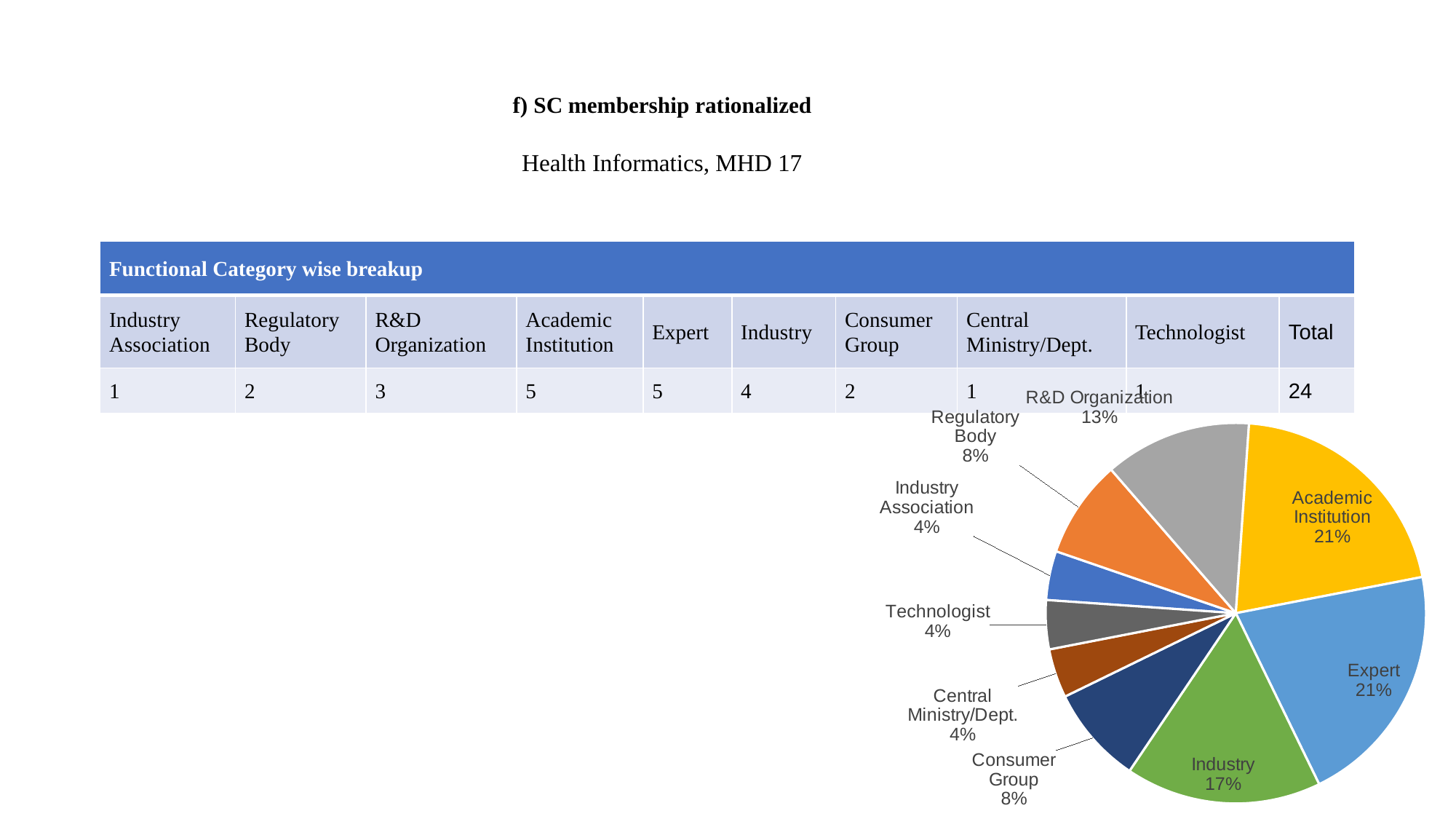
What percentage is labelled for Expert in the pie chart? 21% What percentage is shown for Regulatory Body in the pie chart? 8% What kind of chart is shown on the slide? Pie chart Which is larger in the pie chart, Industry or Consumer Group? Industry What is the difference in percentage points between Industry and Consumer Group in the pie chart? 9 How many slices does the pie chart have? 9 What share does Consumer Group have in the pie chart? 8% What percentage is shown for R&D Organization in the pie chart? 13% What is the difference in percentage points between Academic Institution and R&D Organization in the pie chart? 8 What share of the pie chart is Technologist? 4% What share of the pie chart does Industry represent? 17% Which is larger in the pie chart, R&D Organization or Regulatory Body? R&D Organization